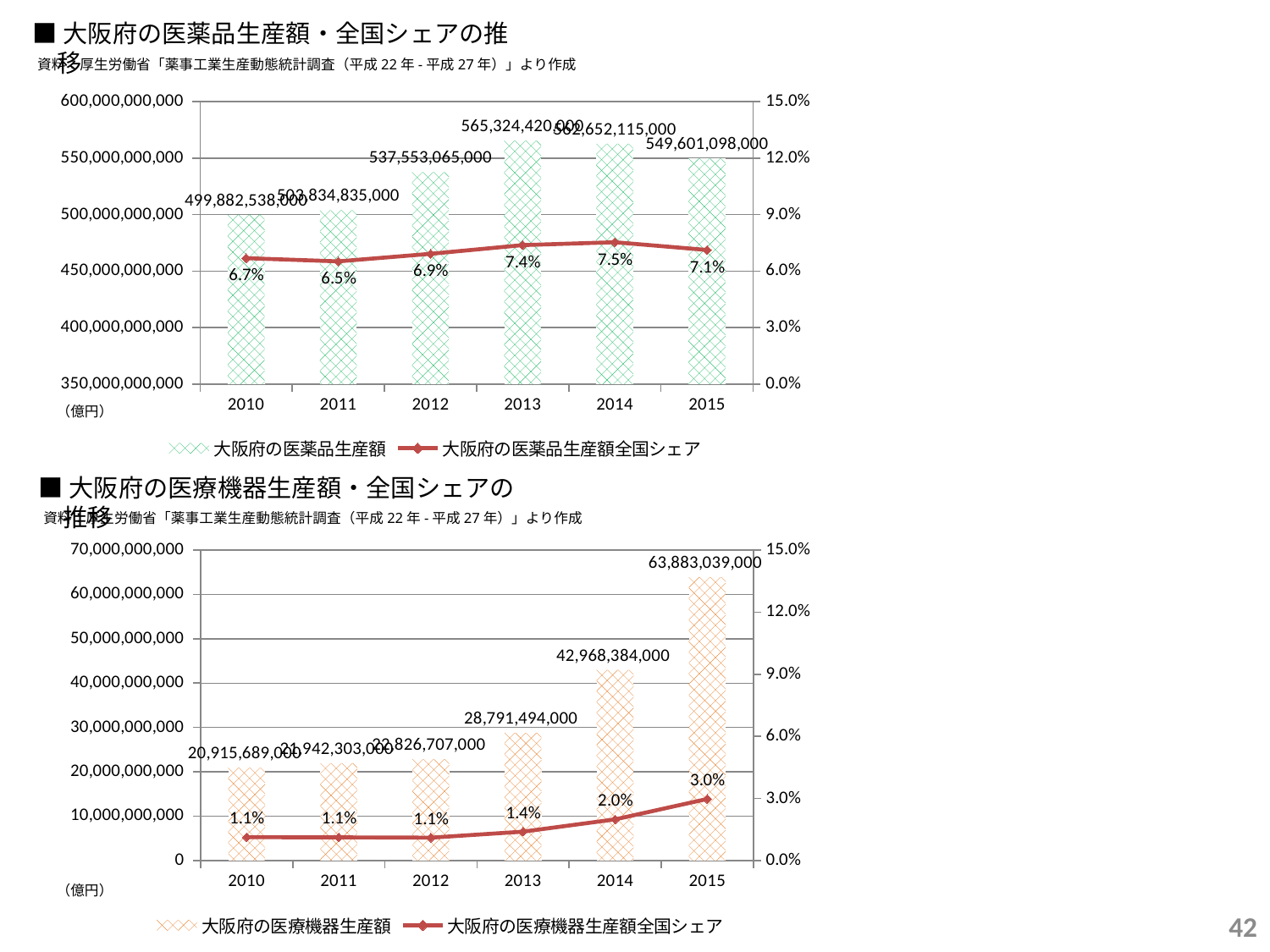
In the bottom chart (大阪府の医療機器生産額・全国シェアの推移), which year has the highest production value? 2015 In the bottom chart (大阪府の医療機器生産額・全国シェアの推移), what is the 大阪府の医療機器生産額 value for 2015? 63,883,039,000 In the bottom chart (大阪府の医療機器生産額・全国シェアの推移), is the production value for 2013 greater or less than 30,000,000,000? less In the bottom chart (大阪府の医療機器生産額・全国シェアの推移), what is the 全国シェア for 2014? 2.0% In the top chart (大阪府の医薬品生産額・全国シェアの推移), what is the 全国シェア for 2014? 7.5% In the top chart (大阪府の医薬品生産額・全国シェアの推移), what is the 大阪府の医薬品生産額 value for 2013? 565,324,420,000 In the top chart (大阪府の医薬品生産額・全国シェアの推移), how many years are shown on the x axis? 6 In the bottom chart (大阪府の医療機器生産額・全国シェアの推移), does the production value rise or fall from 2010 to 2015? rise In the top chart (大阪府の医薬品生産額・全国シェアの推移), how many series does the legend list? 2 In the bottom chart (大阪府の医療機器生産額・全国シェアの推移), what is the difference between the 2015 and 2014 production values? 20,914,655,000 In the top chart (大阪府の医薬品生産額・全国シェアの推移), what is the difference between the 2015 and 2012 production values? 12,048,033,000 In the top chart (大阪府の医薬品生産額・全国シェアの推移), which year has the lowest 全国シェア? 2011